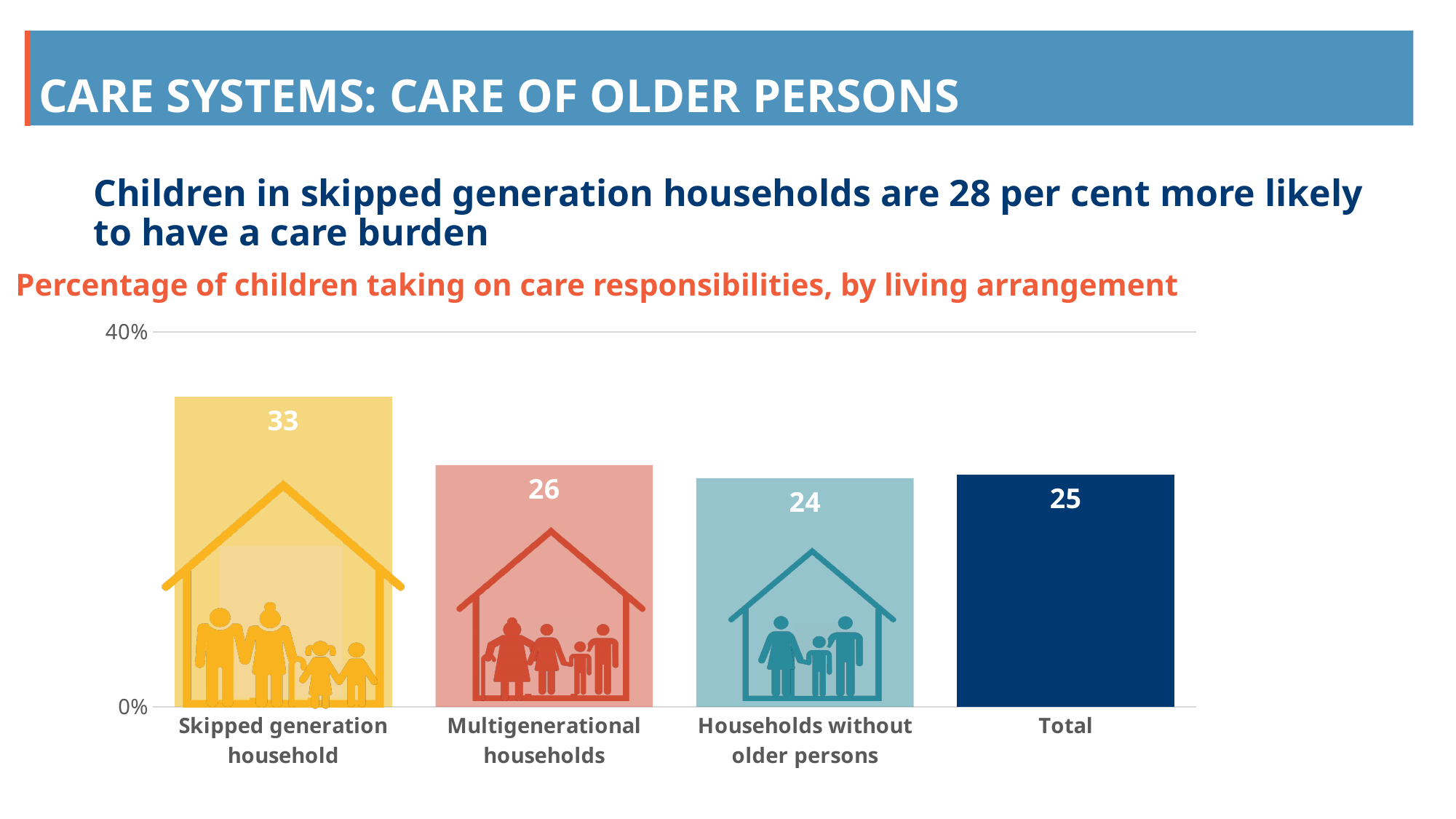
What is the value for Multigenerational households? 26 What is the value for Total? 25 Which is larger, the value for Multigenerational households or the value for Total? Multigenerational households What kind of chart is shown on the slide? bar chart What is the value for Skipped generation household? 33 Which living arrangement has the lowest percentage of children taking on care responsibilities? Households without older persons Is the value for Skipped generation household greater or less than 40%? less What is the value for Households without older persons? 24 What is the difference between the values for Skipped generation household and Multigenerational households? 7 What is the title of the chart? Percentage of children taking on care responsibilities, by living arrangement Which living arrangement has the highest percentage of children taking on care responsibilities? Skipped generation household How many categories are shown on the x axis? 4